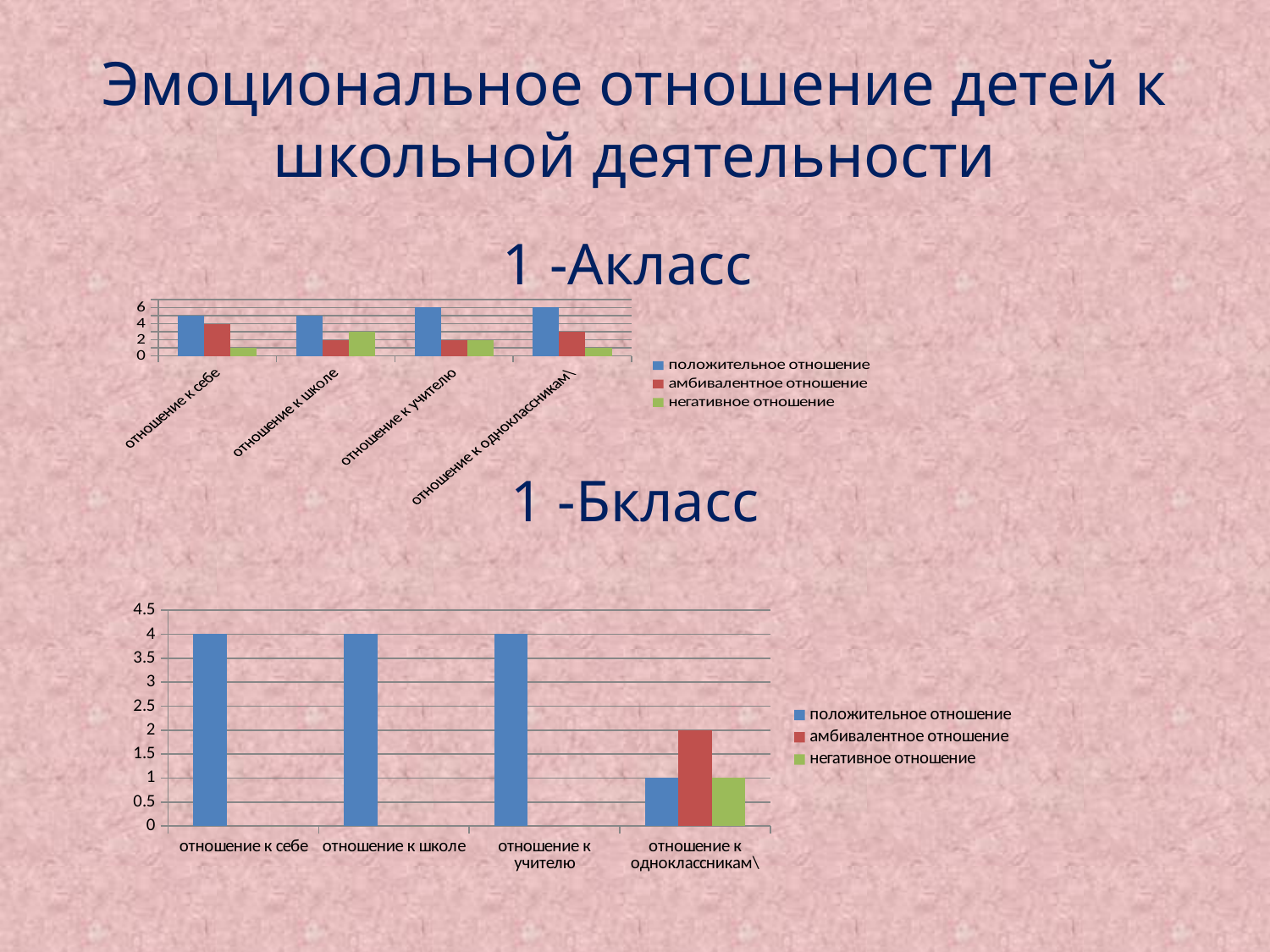
In the "1 -Бкласс" chart, what is the value of негативное отношение for отношение к одноклассникам\? 1 What kind of chart is the "1 -Бкласс" chart? bar chart How many categories are shown on the x axis of the "1 -Акласс" chart? 4 In the "1 -Акласс" chart, is the value of положительное отношение for отношение к учителю greater or less than 4? greater In the "1 -Бкласс" chart, what is the value of положительное отношение for отношение к одноклассникам\? 1 In the "1 -Акласс" chart, which colour represents амбивалентное отношение? red In the "1 -Акласс" chart, for отношение к себе, which is larger: положительное отношение or негативное отношение? положительное отношение How many series does the legend of the "1 -Бкласс" chart list? 3 In the "1 -Бкласс" chart, which category has the lowest value for положительное отношение? отношение к одноклассникам\ In the "1 -Бкласс" chart, what is the difference between положительное отношение for отношение к школе and положительное отношение for отношение к одноклассникам\? 3 In the "1 -Бкласс" chart, what is the value of амбивалентное отношение for отношение к одноклассникам\? 2 In the "1 -Бкласс" chart, what is the value of положительное отношение for отношение к себе? 4